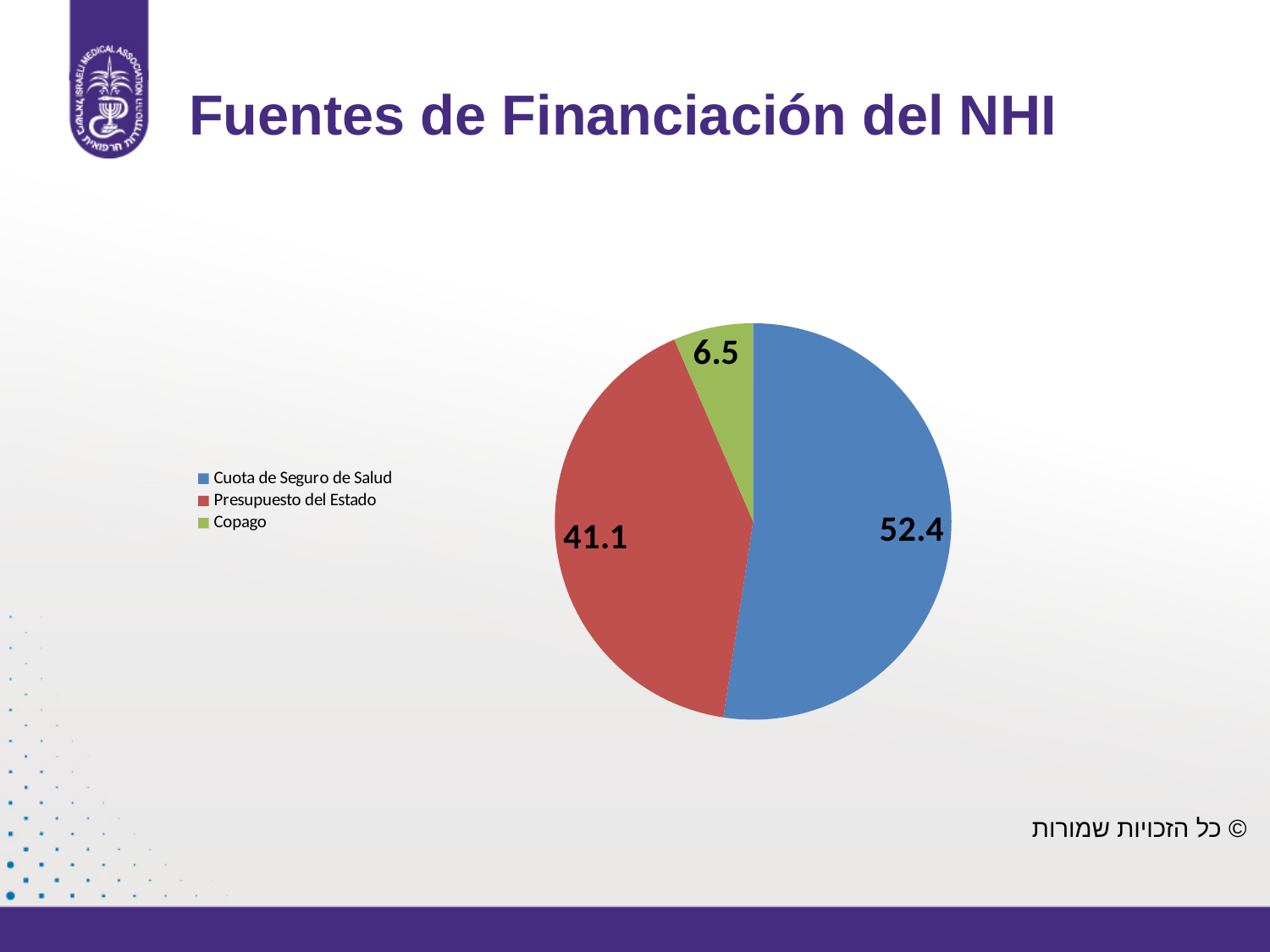
Which is larger, Presupuesto del Estado or Copago? Presupuesto del Estado What is the title of the slide containing the chart? Fuentes de Financiación del NHI What is the difference between the values for Cuota de Seguro de Salud and Presupuesto del Estado? 11.3 What type of chart is shown on the slide? pie chart What is the value for Copago? 6.5 What colour is the slice for Copago? green What is the value for Cuota de Seguro de Salud? 52.4 What is the difference between the values for Presupuesto del Estado and Copago? 34.6 How many categories does the pie chart have? 3 Which category has the largest slice of the pie? Cuota de Seguro de Salud Which category has the smallest slice of the pie? Copago What is the value for Presupuesto del Estado? 41.1